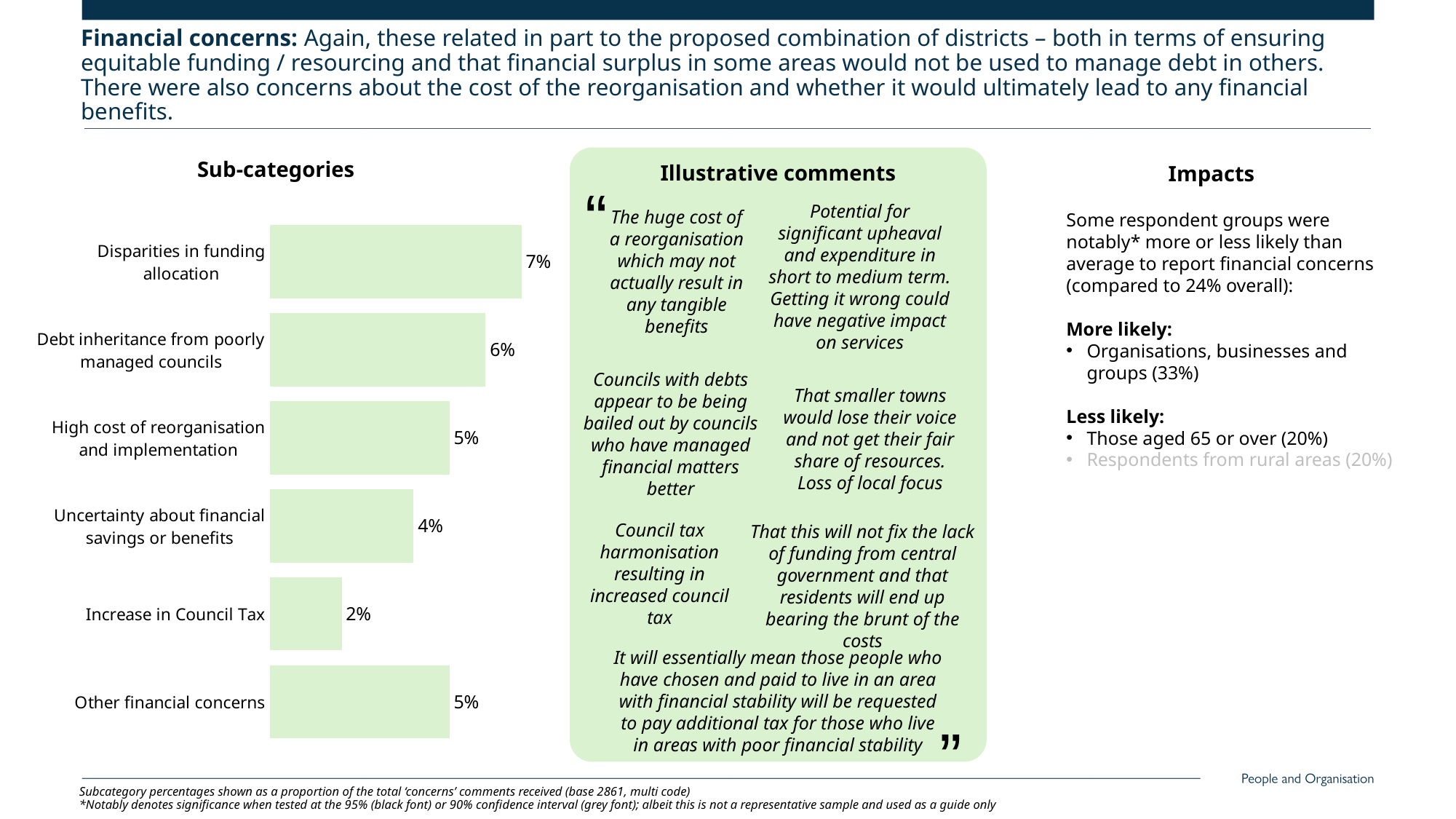
What is the value for Increase in Council Tax? 2% What is the difference between High cost of reorganisation and implementation and Uncertainty about financial savings or benefits? 1% What is the difference between Disparities in funding allocation and Increase in Council Tax? 5% Which is larger: Debt inheritance from poorly managed councils or High cost of reorganisation and implementation? Debt inheritance from poorly managed councils What kind of chart is shown under Sub-categories? Bar chart What is the value for Debt inheritance from poorly managed councils? 6% Which sub-category has the lowest value? Increase in Council Tax What is the value for Uncertainty about financial savings or benefits? 4% What is the title of the chart? Sub-categories Which sub-category has the highest value? Disparities in funding allocation What is the value for Disparities in funding allocation? 7% How many sub-categories are shown in the chart? 6